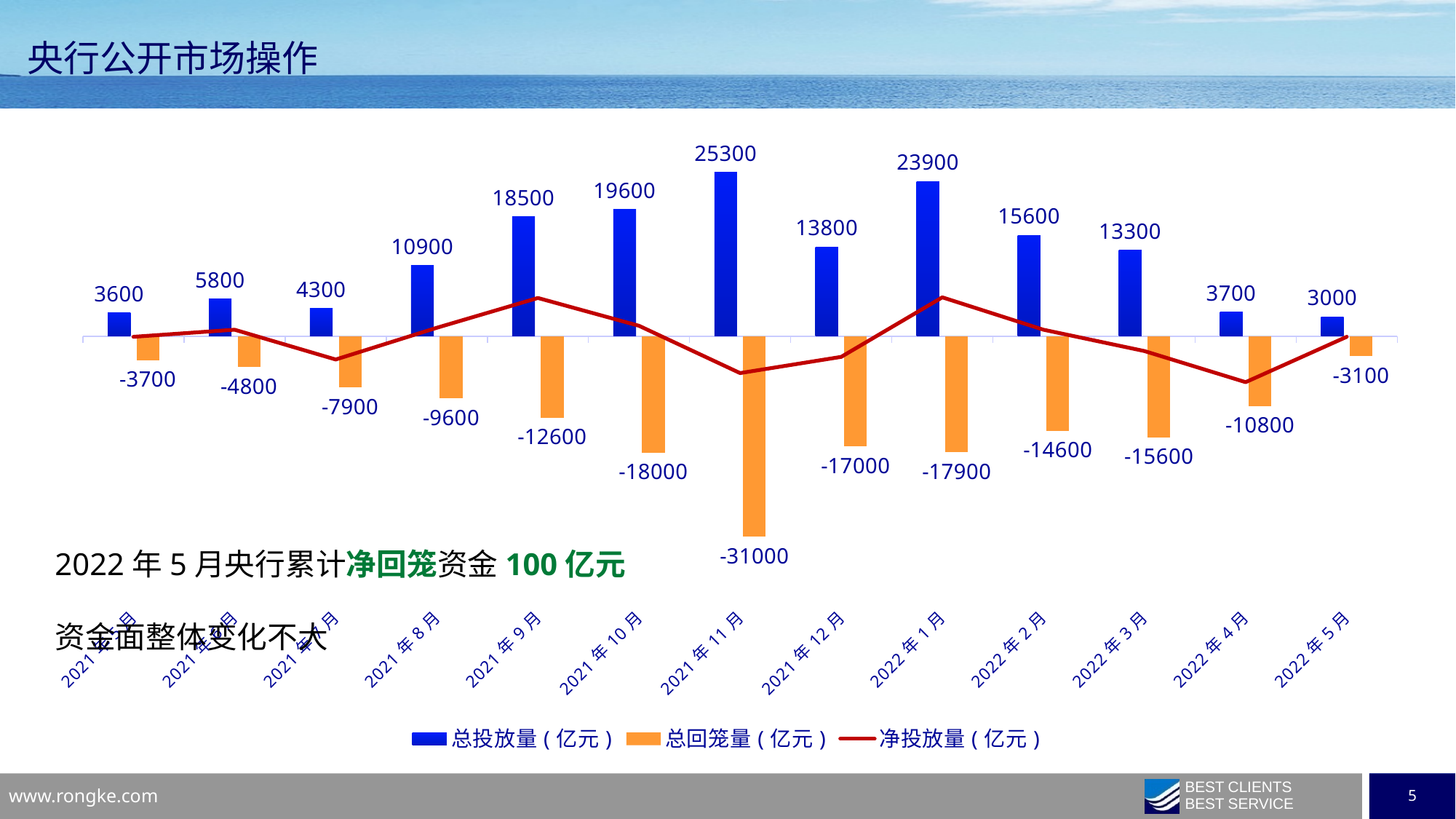
Which month has the largest 总回笼量 (亿元) in magnitude (most negative value)? 2021年11月 What is the 总投放量 (亿元) value for 2022年5月? 3000 What is the 总回笼量 (亿元) value for 2022年1月? -17900 Which month has the lowest 总投放量 (亿元)? 2022年5月 What is the difference between the 总投放量 (亿元) for 2021年11月 and 2022年1月? 1400 Which month has a larger 总投放量 (亿元), 2022年2月 or 2022年3月? 2022年2月 How many months are shown on the x axis of the chart? 13 Which month has the highest 总投放量 (亿元)? 2021年11月 How many series does the legend list? 3 What kind of chart is shown on the slide? Combination bar and line chart What is the 总回笼量 (亿元) value for 2021年10月? -18000 What is the 总投放量 (亿元) value for 2021年11月? 25300